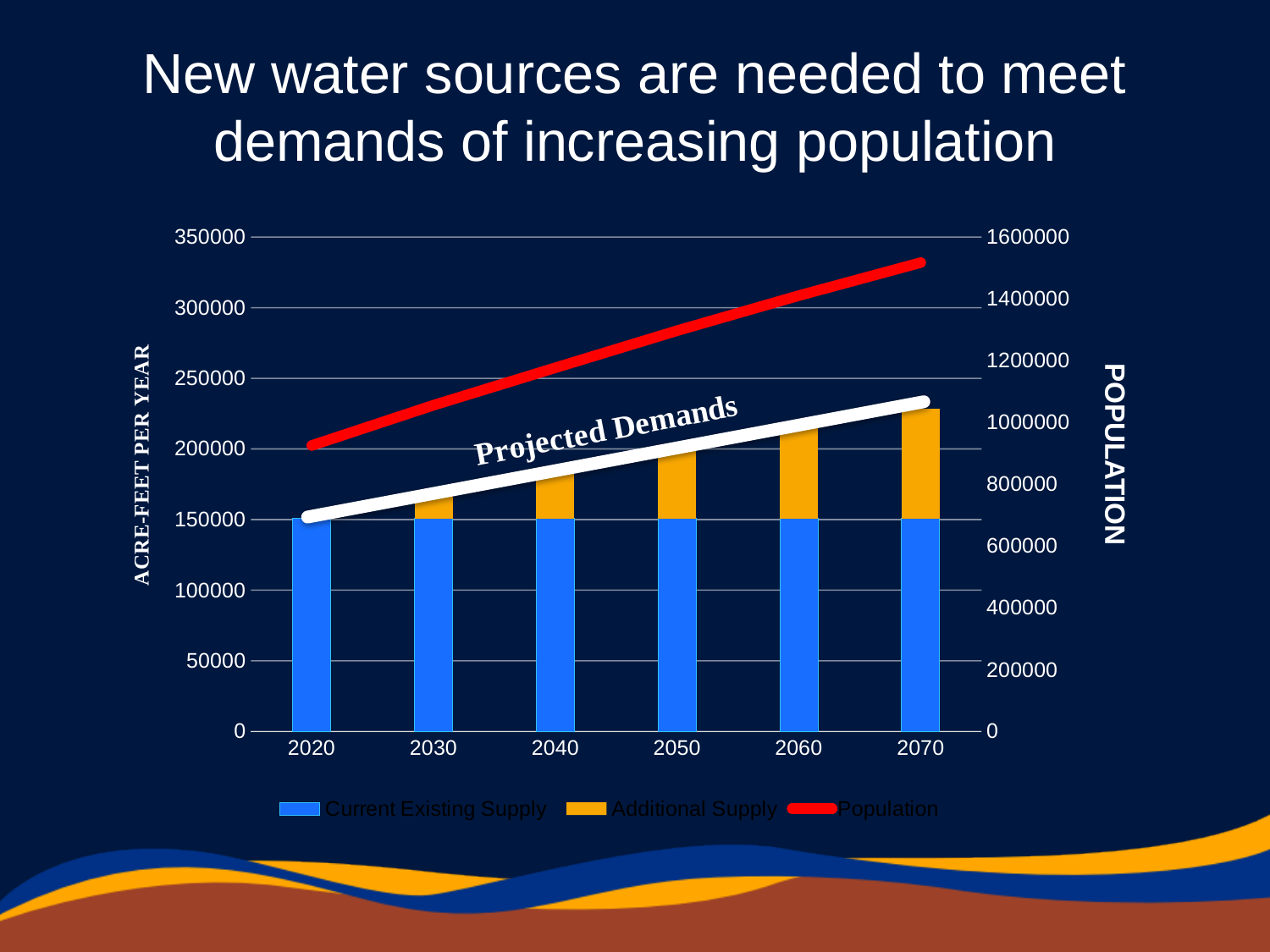
Which stacked bar is taller, 2030 or 2070? 2070 How many years are shown on the x axis of the chart? 6 Which year has the largest Additional Supply? 2070 What is the title of the left vertical axis? ACRE-FEET PER YEAR Is the total height of the stacked bar for 2070 greater or less than 200000? greater Does the Population line rise or fall from 2020 to 2070? rises How many series does the chart legend list? 3 Is the Population value for 2020 greater or less than 1000000? less What kind of chart is shown on the slide? bar chart with a line Is the Population value for 2070 greater or less than 1400000? greater Which year has the smallest Additional Supply? 2020